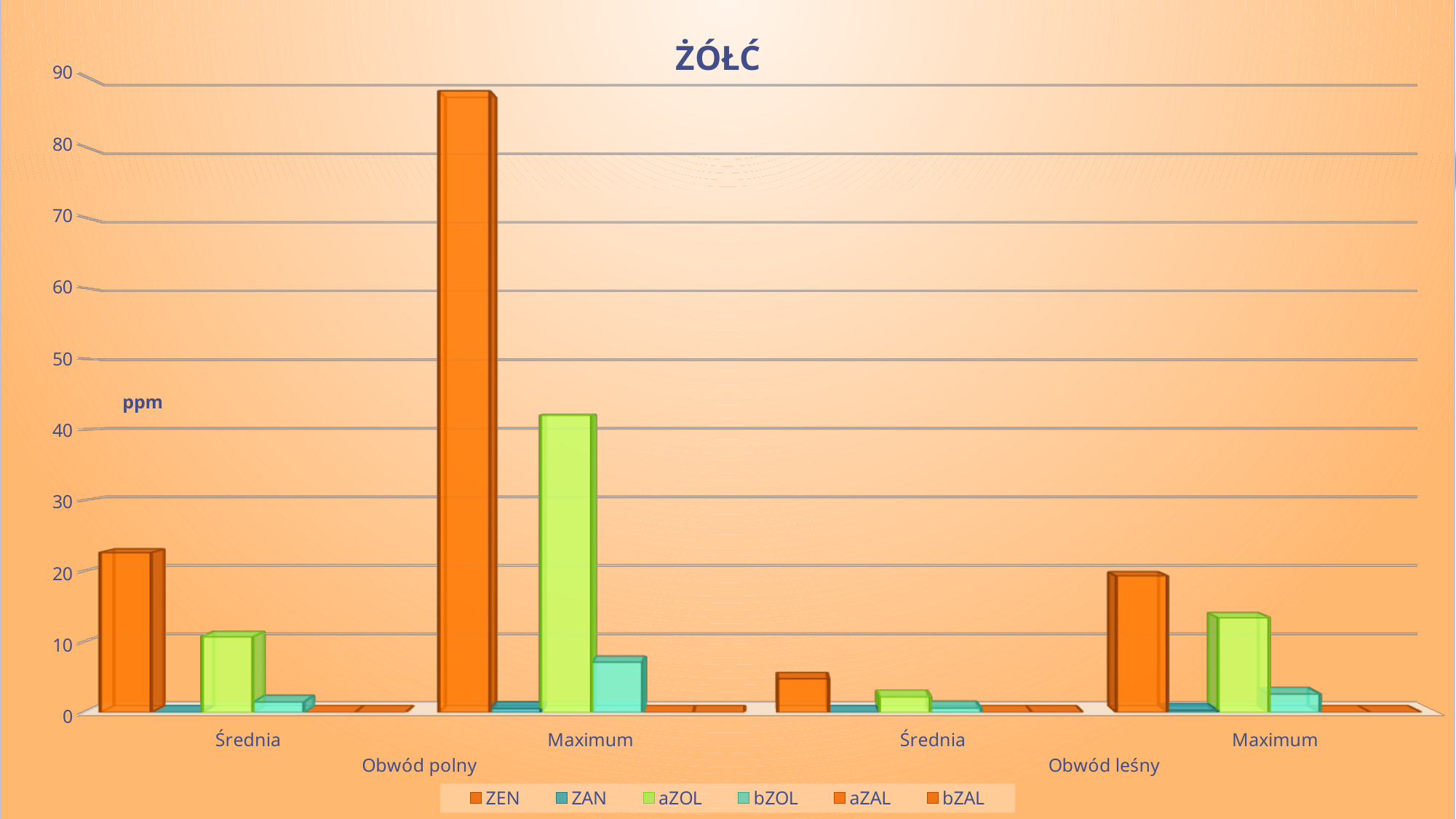
Is the ZEN value for Maximum in Obwód polny greater or less than 80? greater Is the ZEN value for Maximum in Obwód leśny greater or less than 10? greater What unit is shown on the vertical axis? ppm Which series has the highest bar in the Maximum group of Obwód polny? ZEN What kind of chart is shown on the slide? bar chart How many series does the legend list? 6 What is the title of the chart? ŻÓŁĆ How many category groups are shown along the x axis? 4 Which is larger: the ZEN value for Maximum in Obwód polny or the ZEN value for Maximum in Obwód leśny? Obwód polny Is the ZEN value for Średnia in Obwód leśny greater or less than 10? less